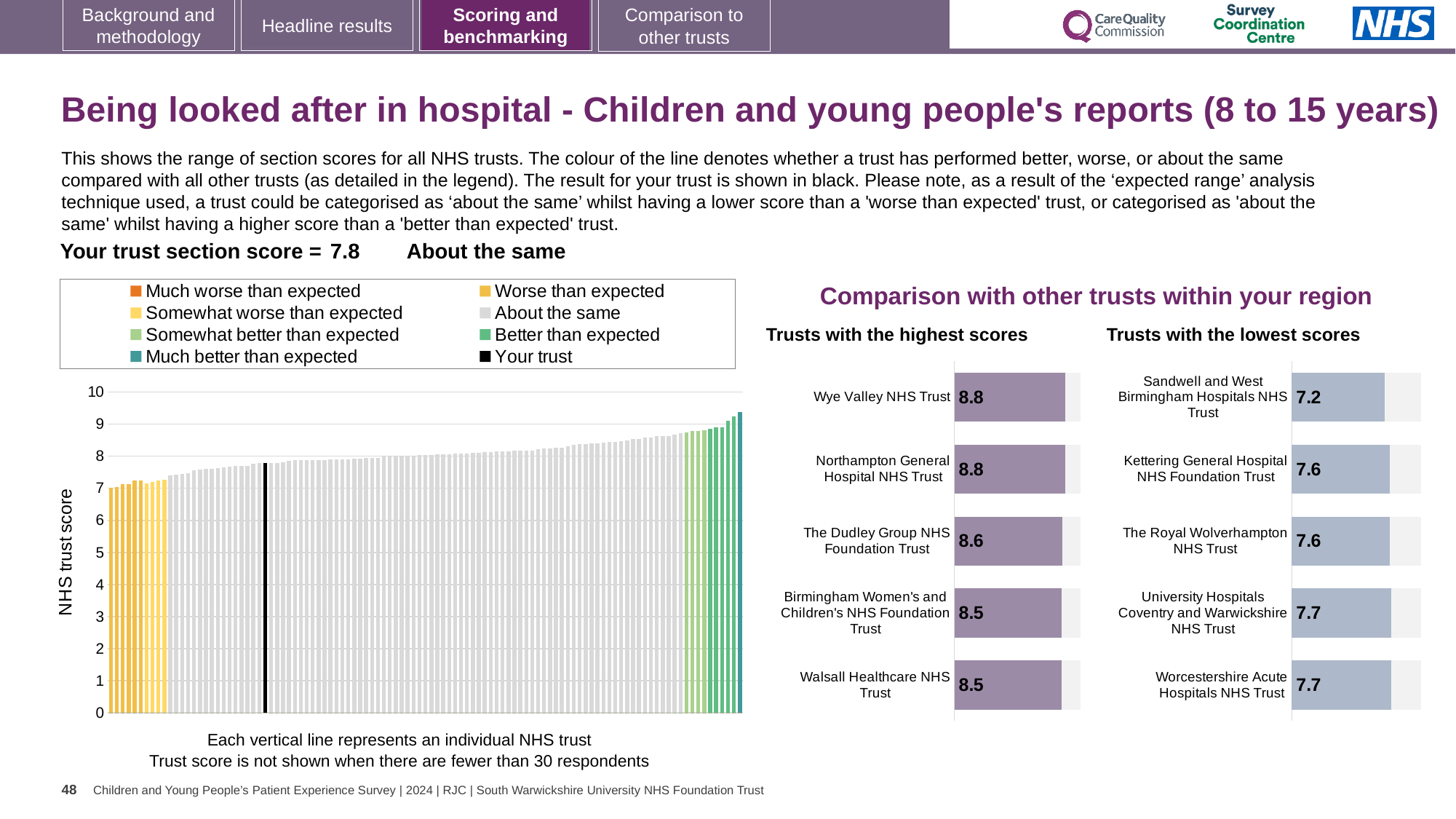
In the 'Trusts with the highest scores' chart, what is the score for Walsall Healthcare NHS Trust? 8.5 In the 'Trusts with the highest scores' chart, what is the difference between the score for Wye Valley NHS Trust and the score for Walsall Healthcare NHS Trust? 0.3 How many entries does the legend above the main 'NHS trust score' chart list? 8 In the main 'NHS trust score' chart on the left, do the bar values rise or fall from left to right? rise In the 'Trusts with the lowest scores' chart, what is the score for Sandwell and West Birmingham Hospitals NHS Trust? 7.2 In the 'Trusts with the highest scores' chart, what is the score for The Dudley Group NHS Foundation Trust? 8.6 In the main 'NHS trust score' chart on the left, is the value for the black 'Your trust' bar greater or less than 8? less How many trusts are listed in the 'Trusts with the highest scores' chart? 5 What kind of chart is the main chart on the left with the y-axis labelled 'NHS trust score'? bar chart In the 'Trusts with the lowest scores' chart, which trust has the lowest score? Sandwell and West Birmingham Hospitals NHS Trust In the 'Trusts with the lowest scores' chart, which has the higher score: Kettering General Hospital NHS Foundation Trust or Worcestershire Acute Hospitals NHS Trust? Worcestershire Acute Hospitals NHS Trust What is the difference between the score for Wye Valley NHS Trust in the 'Trusts with the highest scores' chart and the score for Sandwell and West Birmingham Hospitals NHS Trust in the 'Trusts with the lowest scores' chart? 1.6